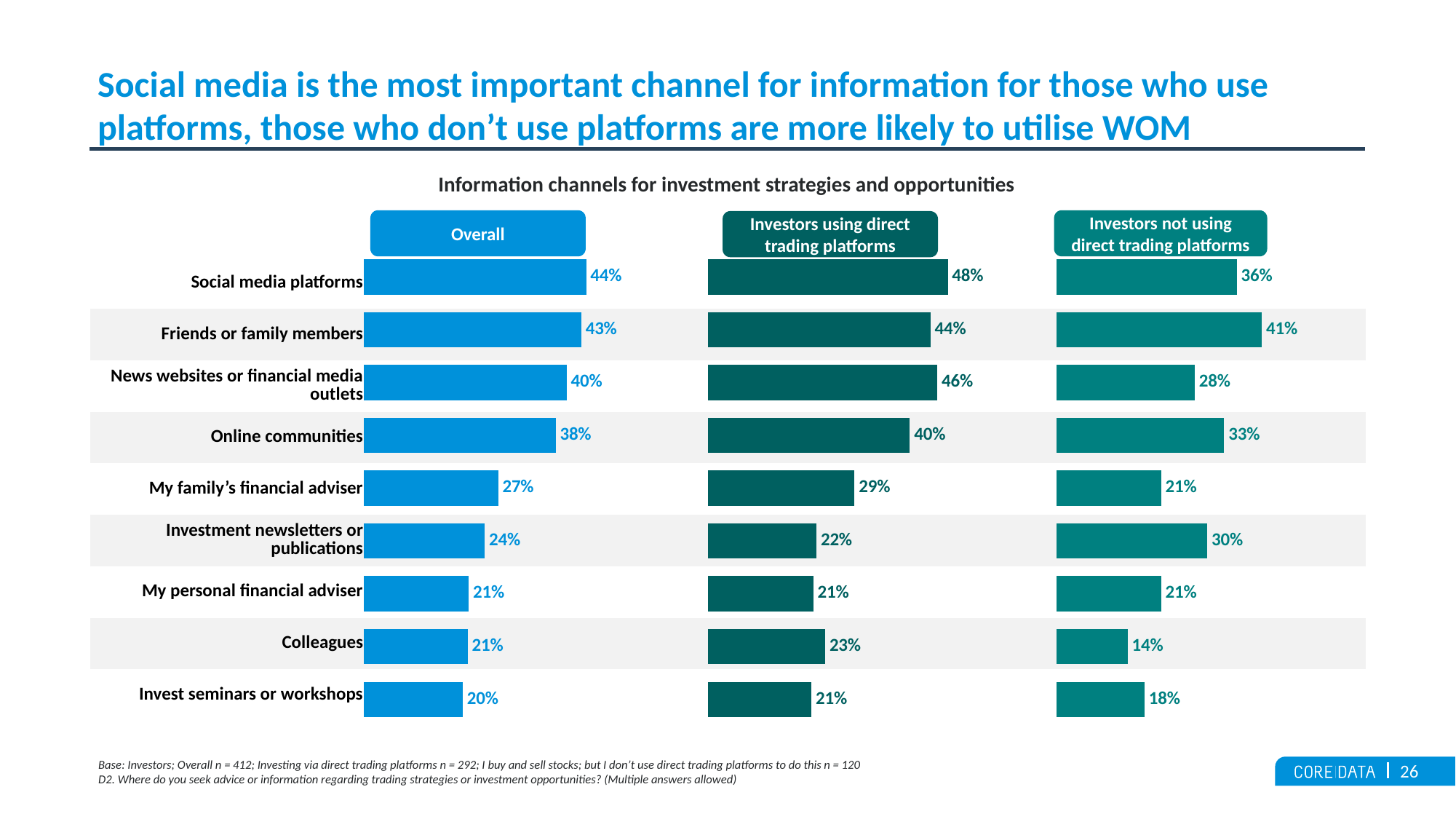
In the Investors not using direct trading platforms chart, which category has the lowest value? Colleagues In the Investors using direct trading platforms chart, which category has the highest value? Social media platforms In the Overall chart, what is the value for Social media platforms? 44% In the Investors not using direct trading platforms chart, what is the value for Investment newsletters or publications? 30% In the Investors using direct trading platforms chart, what is the value for News websites or financial media outlets? 46% For Friends or family members, which is larger: the Overall value or the Investors not using direct trading platforms value? Overall In the Investors not using direct trading platforms chart, what is the value for Invest seminars or workshops? 18% In the Overall chart, do the values rise or fall from Social media platforms down to Invest seminars or workshops? Fall What kind of chart is used on this slide? Bar chart How many categories are shown in the Overall chart? 9 What is the title of the chart on this slide? Information channels for investment strategies and opportunities What is the difference between the Investors using direct trading platforms and Investors not using direct trading platforms values for News websites or financial media outlets? 18 percentage points